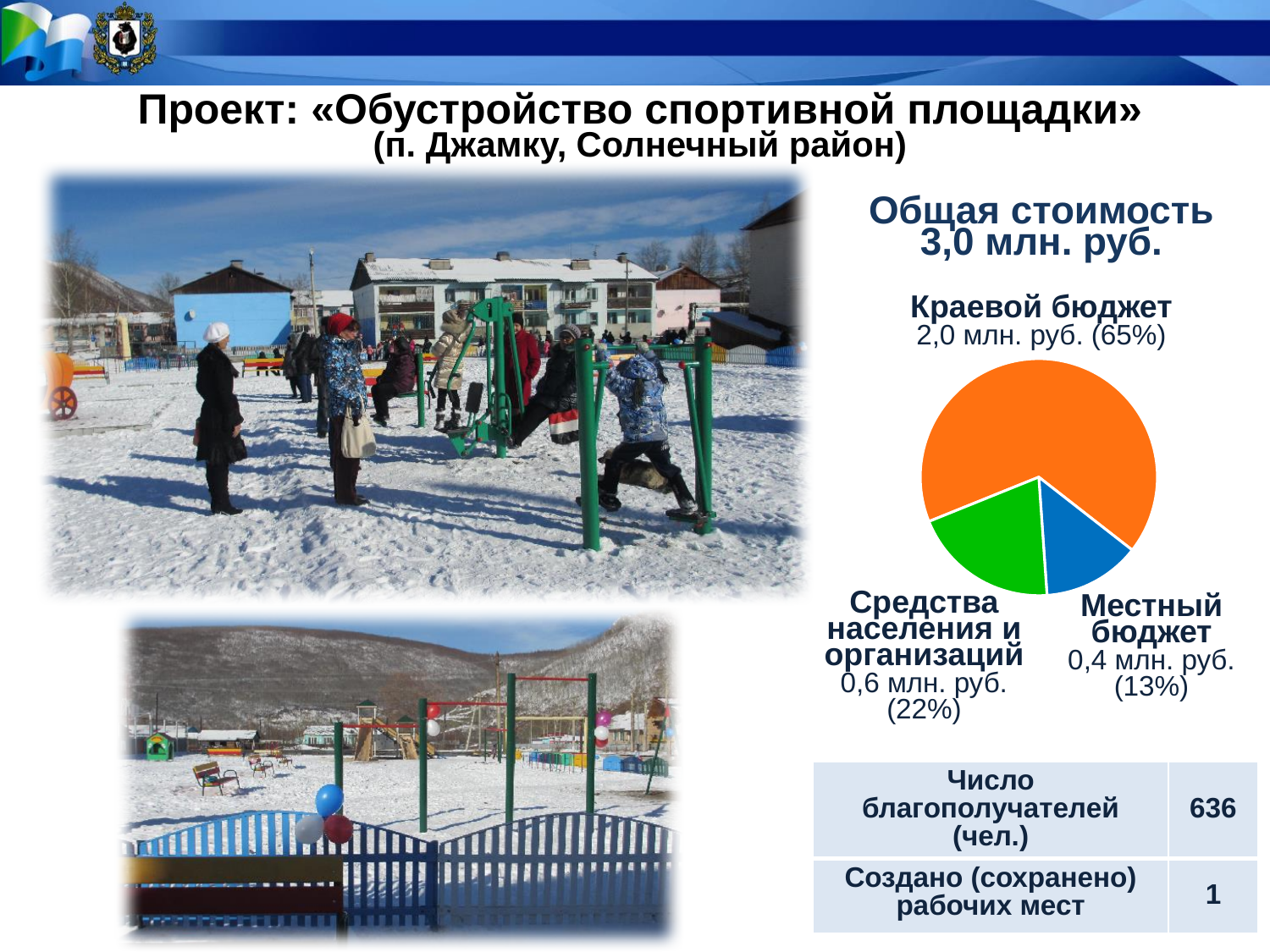
Which is larger in the pie chart: Средства населения и организаций or Местный бюджет? Средства населения и организаций What is the difference between Краевой бюджет and Местный бюджет in the pie chart? 1,6 млн. руб. Which slice of the pie chart is the largest? Краевой бюджет What is the value for Местный бюджет in the pie chart? 0,4 млн. руб. How many slices does the pie chart have? 3 What colour is the Краевой бюджет slice in the pie chart? orange What is the value for Краевой бюджет in the pie chart? 2,0 млн. руб. What kind of chart is shown on the slide? pie chart Which slice of the pie chart is the smallest? Местный бюджет What share of the pie does Местный бюджет represent? 13% What share of the pie does Краевой бюджет represent? 65% What is the value for Средства населения и организаций in the pie chart? 0,6 млн. руб.